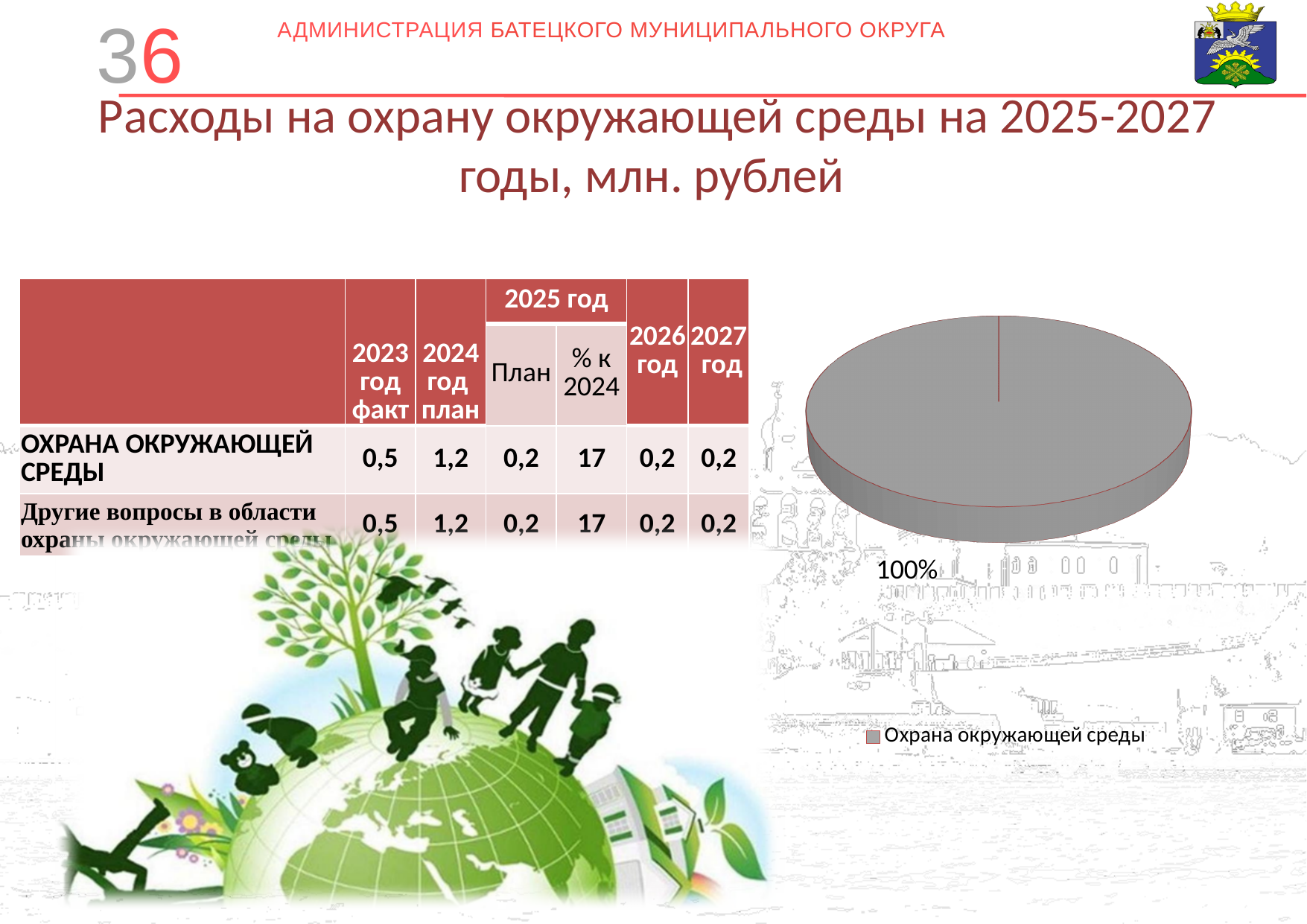
How many slices does the pie chart have? 1 What kind of chart is shown on the right side of the slide? pie chart What colour is the slice in the pie chart? grey What percentage label is printed on the pie chart? 100% How many entries does the legend of the pie chart list? 1 What share of the pie chart does the slice "Охрана окружающей среды" take? 100% What is the legend entry of the pie chart? Охрана окружающей среды